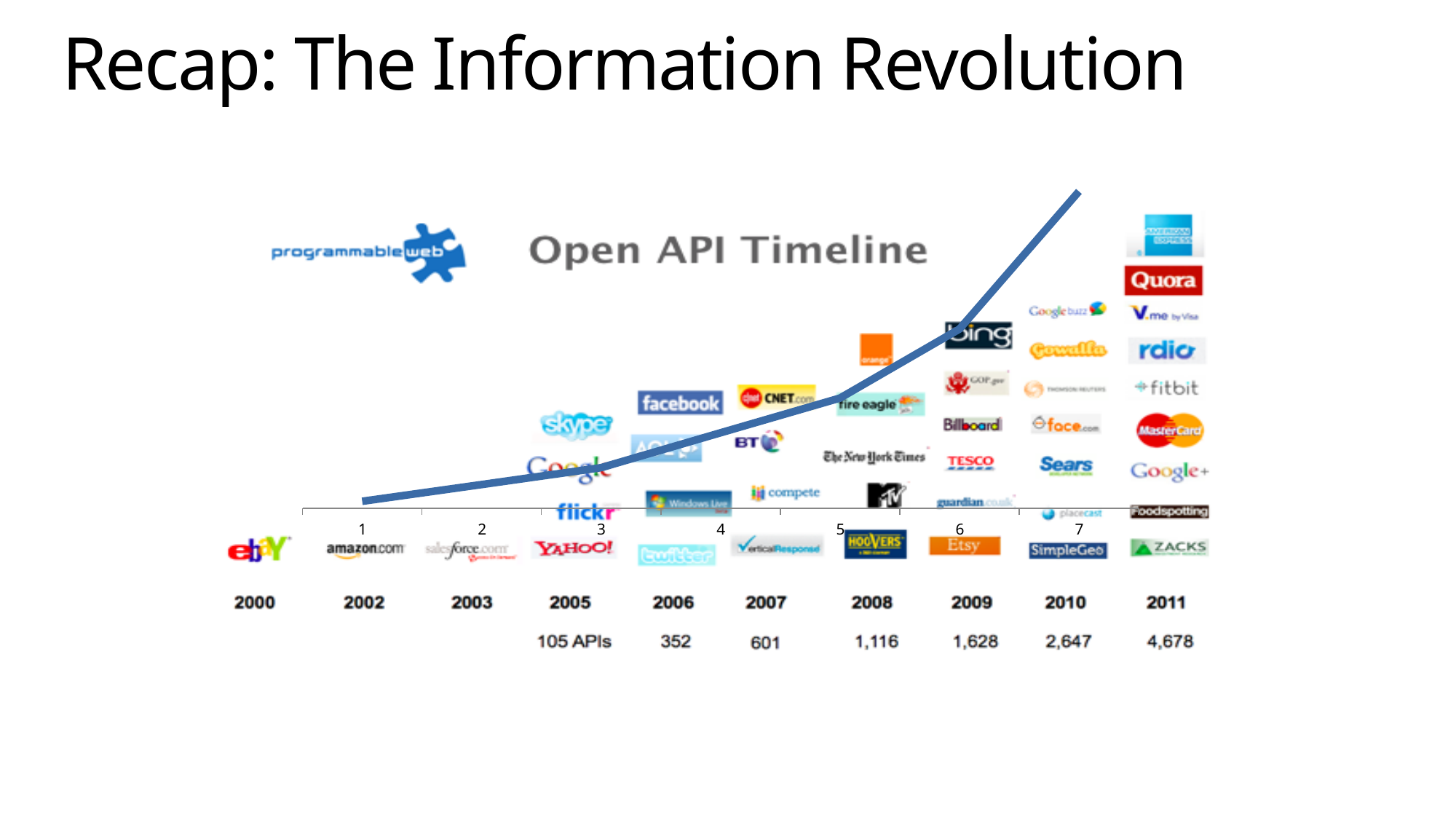
What API count is printed for 2011 on the Open API Timeline? 4,678 Which year on the Open API Timeline has the lowest printed API count? 2005 What is the difference between the API counts printed for 2011 and 2010 on the Open API Timeline? 2,031 What is the title shown on the timeline image? Open API Timeline What kind of chart is overlaid on the Open API Timeline image? line chart How many numbered tick marks are shown on the x axis of the overlaid line chart? 7 Which year has a larger printed API count on the Open API Timeline, 2006 or 2007? 2007 What API count is printed for 2008 on the Open API Timeline? 1,116 What is the difference between the API counts printed for 2010 and 2009 on the Open API Timeline? 1,019 Which year on the Open API Timeline has the highest printed API count? 2011 How many APIs are listed for 2005 on the Open API Timeline? 105 APIs Does the overlaid line rise or fall from left to right along the x axis? rise